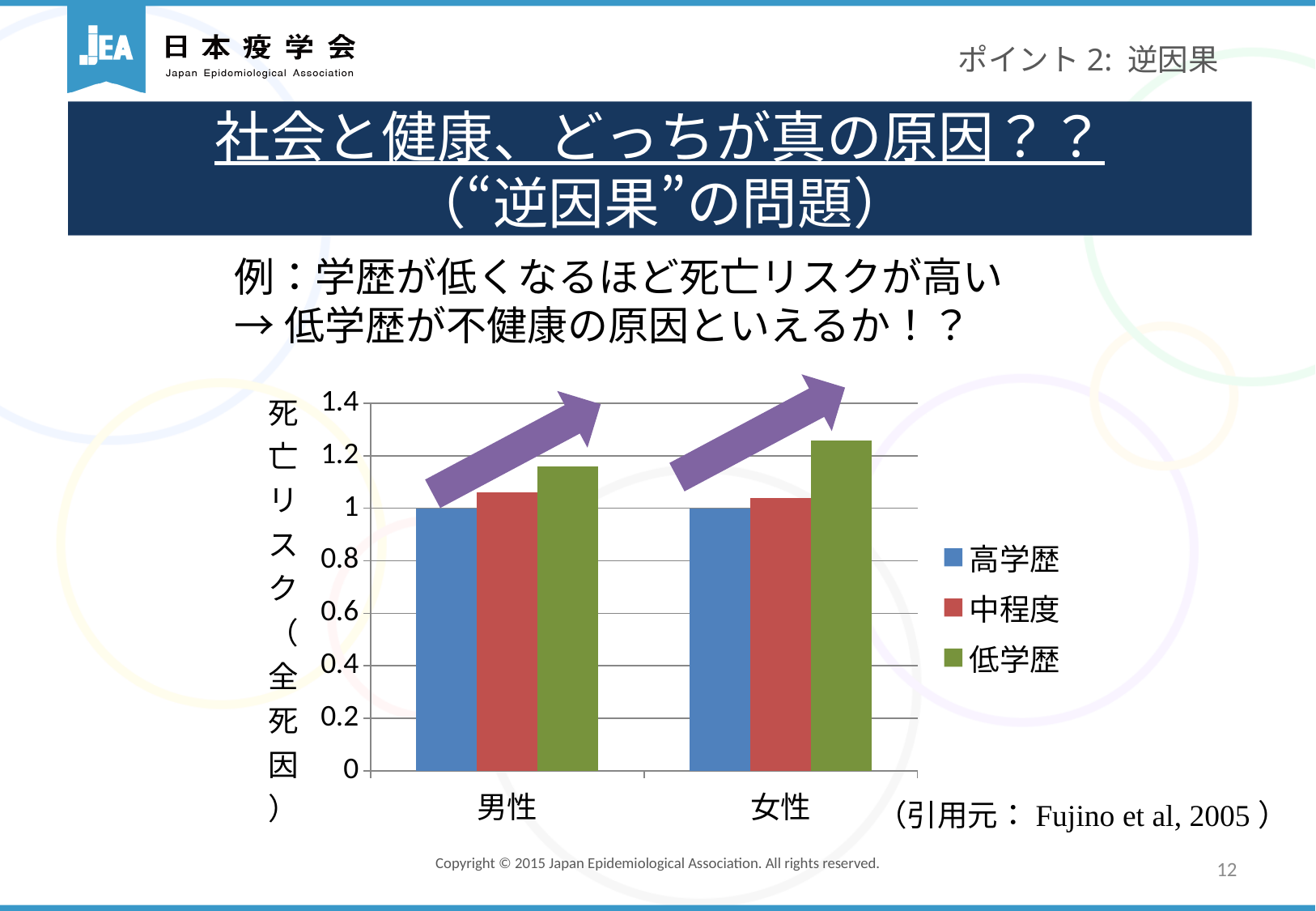
What is the value of 高学歴 for 男性? 1 What kind of chart is shown on the slide? bar chart Within each sex group, do the values rise or fall going from 高学歴 to 低学歴? rise Is the value of 低学歴 for 女性 greater or less than 1.2? greater Which is larger: 低学歴 for 男性 or 低学歴 for 女性? 低学歴 for 女性 Is the value of 低学歴 for 男性 greater or less than 1.2? less What is the label of the chart's vertical axis? 死亡リスク（全死因） How many series does the chart legend list? 3 Which series has the highest value for 女性? 低学歴 What is the value of 高学歴 for 女性? 1 How many categories are shown on the x axis of the chart? 2 Which series has the highest value for 男性? 低学歴